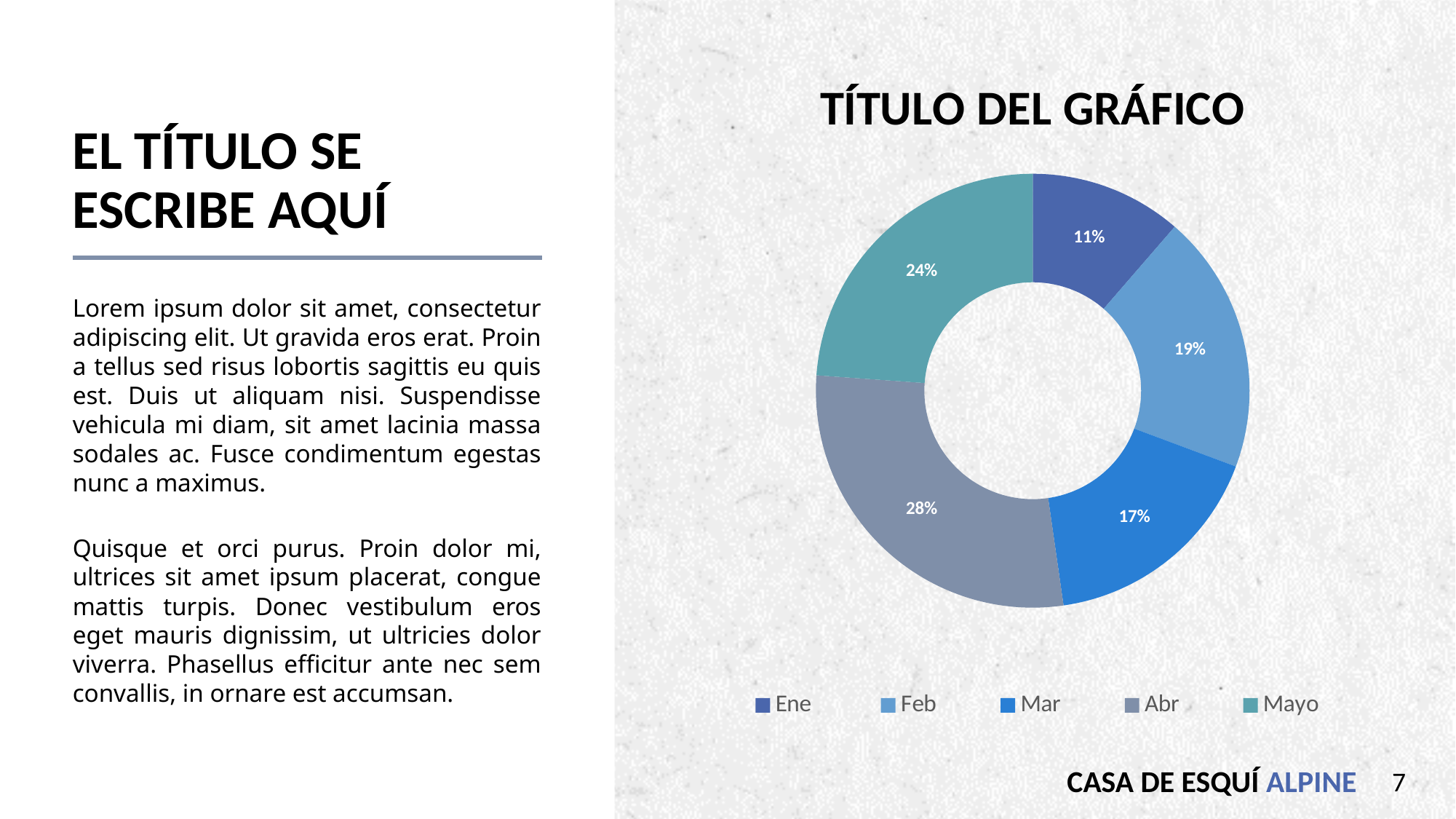
Which legend entry is shown in teal? Mayo What is the title of the chart? TÍTULO DEL GRÁFICO Which has a larger share, Feb or Mar? Feb How many categories does the chart show? 5 What is the difference in percentage points between Abr and Ene? 17 What kind of chart is shown on the slide? Doughnut chart Which category has the largest share of the chart? Abr What share of the chart does Mayo represent? 24% What share of the chart does Abr represent? 28% What share of the chart does Ene represent? 11% What share of the chart does Feb represent? 19% Which category has the smallest share of the chart? Ene